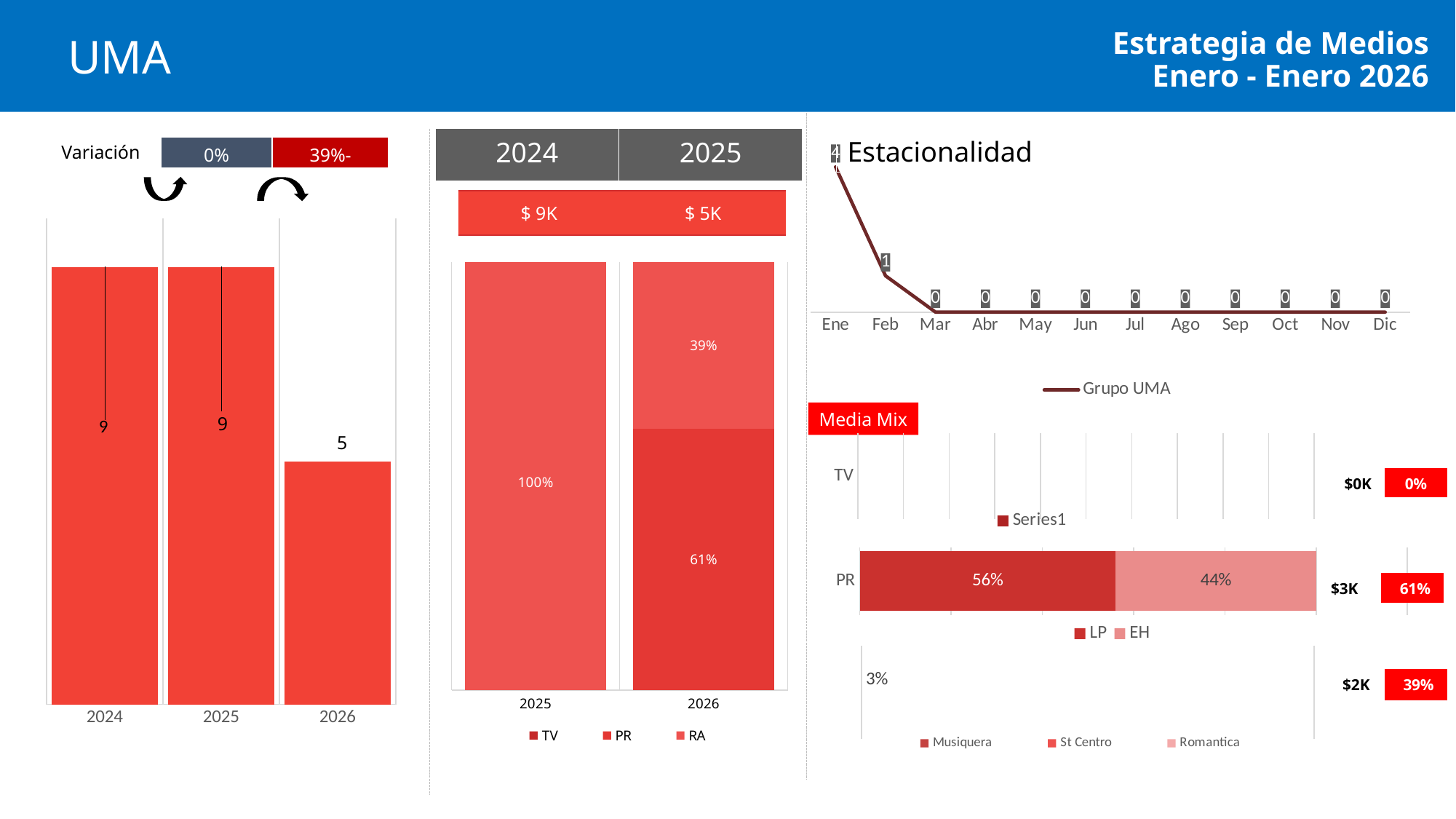
In the bar chart on the left, which year has the lowest value? 2026 In the bar chart on the left, do the values rise or fall from 2025 to 2026? fall In the bar chart on the left, what is the value for 2024? 9 In the stacked bar chart in the middle, what percentage does the top segment of the 2026 bar show? 39% In the bar chart on the left, how many years are shown on the x axis? 3 In the stacked bar chart in the middle, how many series does the legend list? 3 In the bar chart on the left, what is the value for 2026? 5 In the stacked bar chart in the middle, what percentage does the 2025 bar show? 100% In the Estacionalidad line chart, what is the value for Ene? 4 In the bar chart on the left, what is the difference between the values for 2025 and 2026? 4 In the Estacionalidad line chart, which month has the highest value? Ene In the Media Mix PR bar, what percentage is shown for LP? 56%